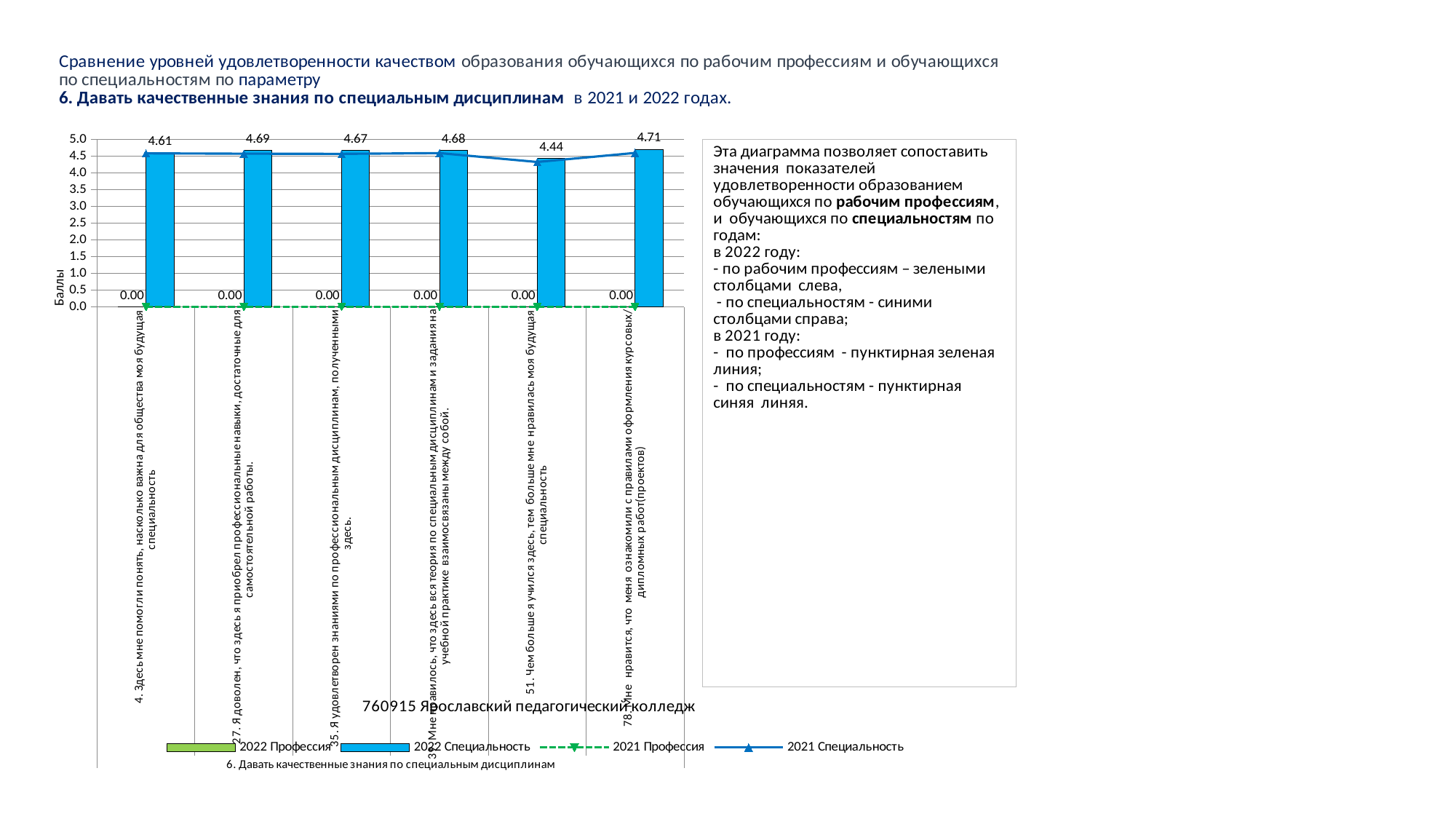
What is the value of the 2022 Специальность series for category "4. Здесь мне помогли понять, насколько важна для общества моя будущая специальность"? 4.61 In the 2022 Специальность series, which is larger: the value for category 4 or the value for category 27? Category 27 (4.69) What is the difference between the highest and lowest values in the 2022 Специальность series? 0.27 What is the value of the 2022 Профессия series for category "27. Я доволен, что здесь я приобрел профессиональные навыки, достаточные для самостоятельной работы."? 0.00 How many series does the chart legend list? 4 What is the title of the vertical axis of the chart? Баллы What is the value of the 2022 Специальность series for category "51. Чем больше я учился здесь, тем больше мне нравилась моя будущая специальность"? 4.44 Which category has the highest value in the 2022 Специальность series? 78. Мне нравится, что меня ознакомили с правилами оформления курсовых/дипломных работ(проектов) How many categories are shown on the x axis of the chart? 6 Is the 2022 Специальность value for category 51 greater or less than 4.0? greater What is the value of the 2022 Специальность series for category "78. Мне нравится, что меня ознакомили с правилами оформления курсовых/дипломных работ(проектов)"? 4.71 Which category has the lowest value in the 2022 Специальность series? 51. Чем больше я учился здесь, тем больше мне нравилась моя будущая специальность